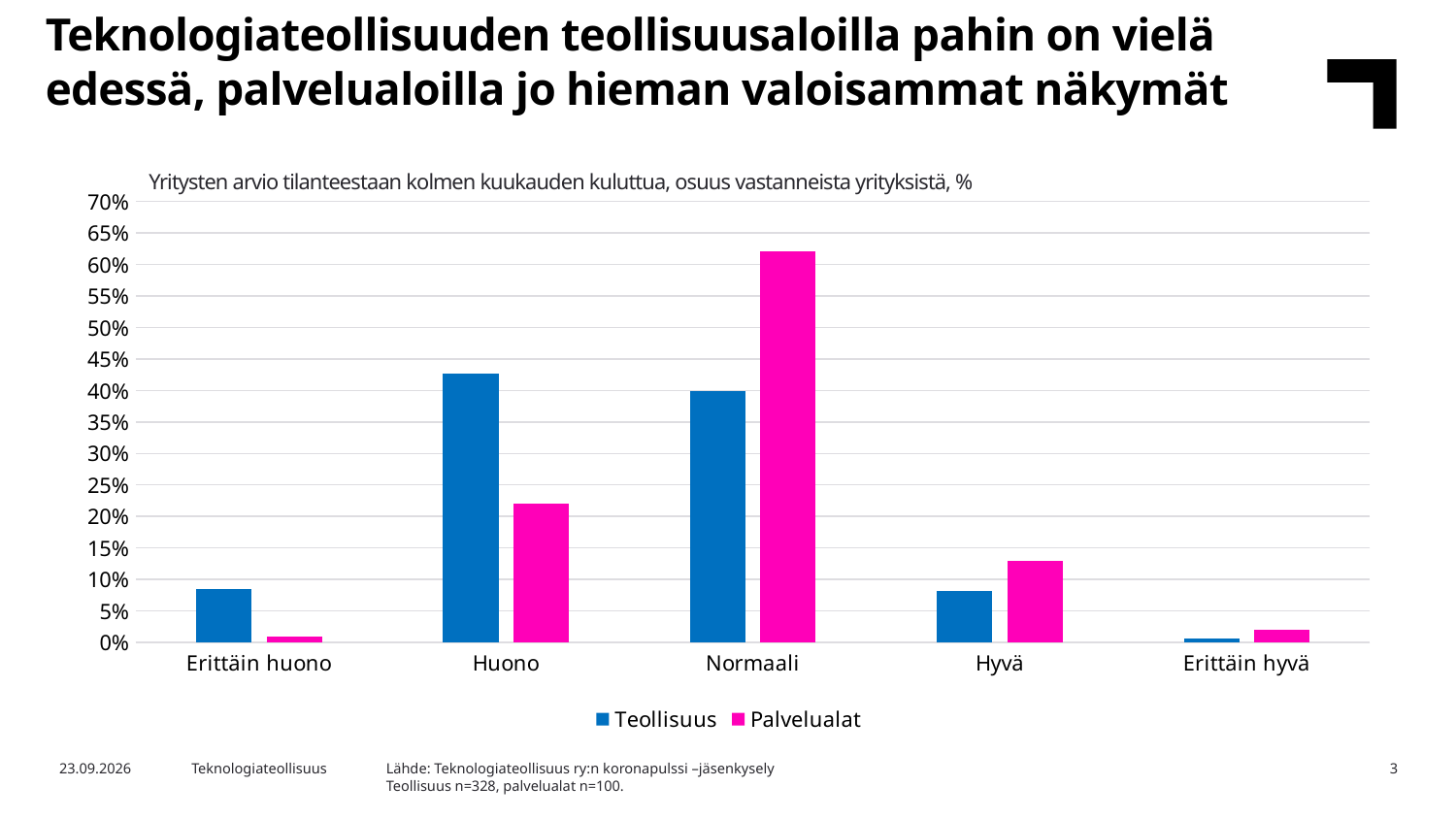
What kind of chart is shown on the slide? bar chart Is the Palvelualat value for Normaali greater or less than 55%? greater Which series is shown in magenta in the chart legend? Palvelualat Is the Palvelualat value for Huono greater or less than 25%? less How many series does the chart legend list? 2 For the Huono category, which series has the larger value, Teollisuus or Palvelualat? Teollisuus Which category has the highest value for the Teollisuus series? Huono Which category has the lowest value for the Teollisuus series? Erittäin hyvä Which category has the highest value for the Palvelualat series? Normaali How many categories are shown on the x axis of the chart? 5 For the Normaali category, which series has the larger value, Teollisuus or Palvelualat? Palvelualat For the Erittäin huono category, which series has the larger value, Teollisuus or Palvelualat? Teollisuus